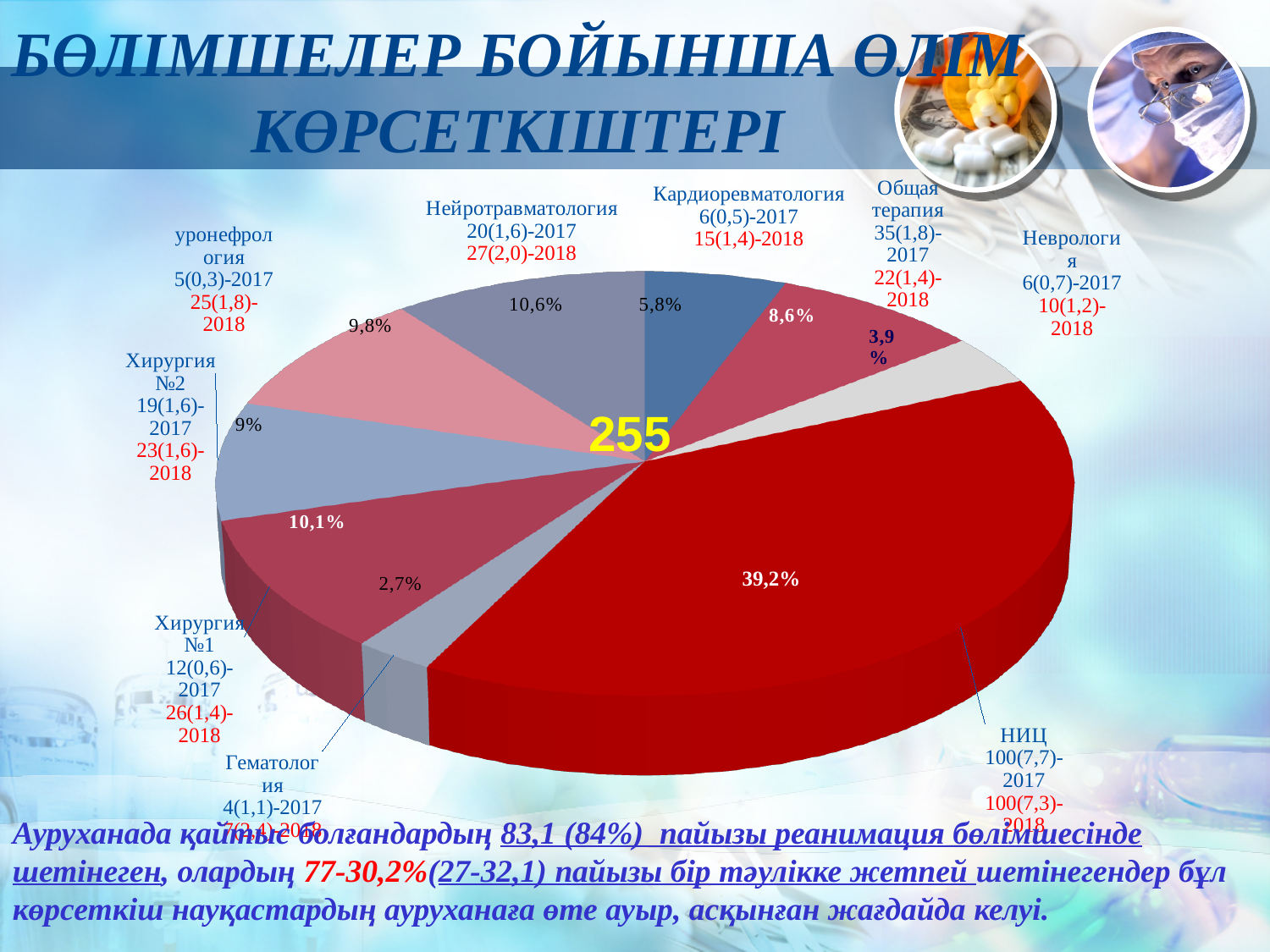
Which department has the smallest slice of the pie chart? Гематология Which slice is larger, Хирургия №1 or Хирургия №2? Хирургия №1 What kind of chart is shown on the slide? pie chart What percentage is shown for the Общая терапия slice? 8,6% Which department has the largest slice of the pie chart? НИЦ What percentage is shown for the Нейротравматология slice? 10,6% What percentage is shown for the НИЦ slice? 39,2% What is the difference in percentage points between the НИЦ slice (39,2%) and the Нейротравматология slice (10,6%)? 28,6 What percentage is shown for the Гематология slice? 2,7% What is the 2018 value shown in the label for Неврология? 10(1,2) How many slices does the pie chart have? 9 What number is printed in the centre of the pie chart? 255